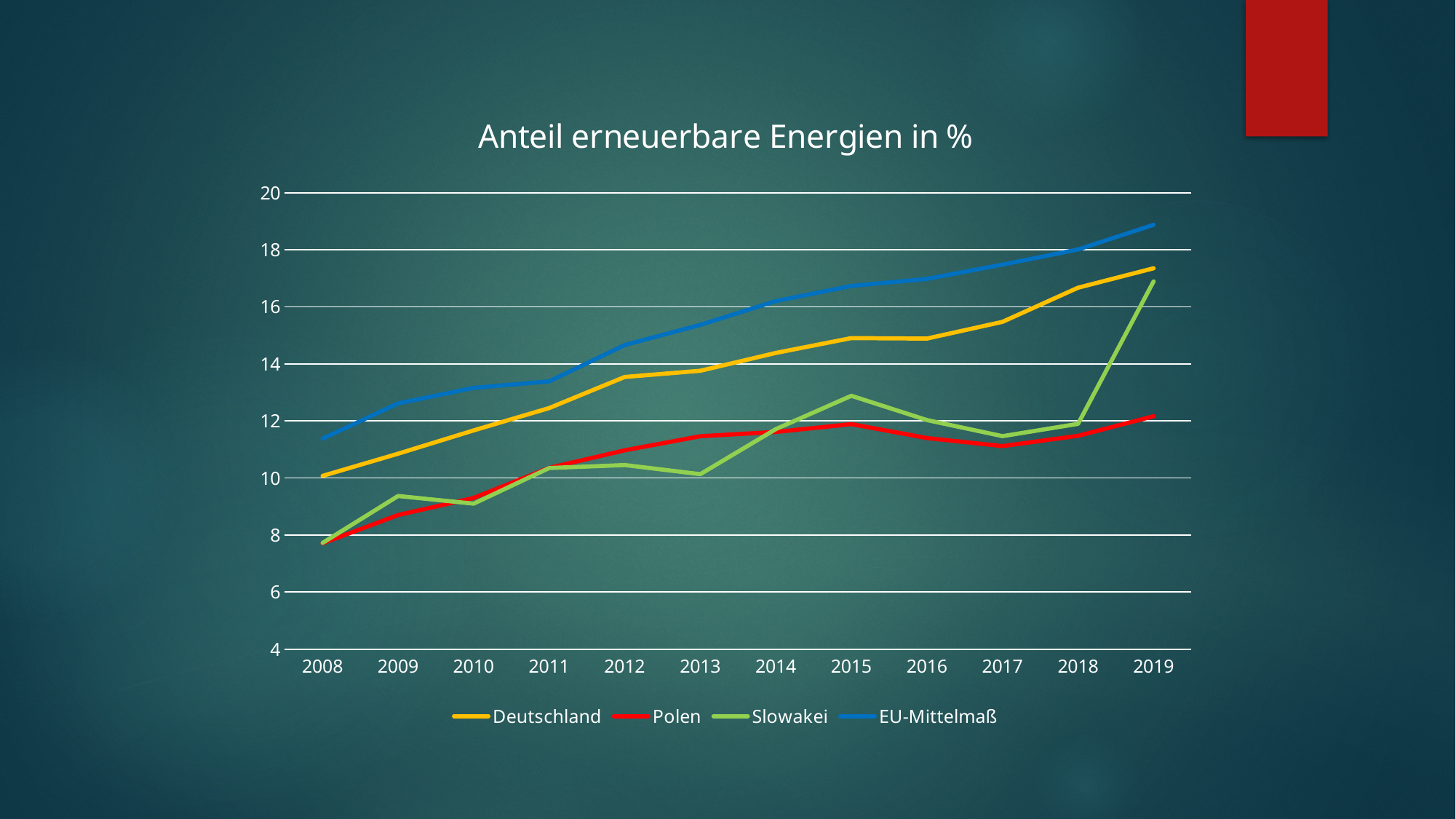
Which series has the lowest value in 2019? Polen What kind of chart is shown on the slide? line chart Is the value for EU-Mittelmaß in 2008 greater or less than 12? less How many years are shown on the x axis? 12 Is the value for Deutschland in 2019 greater or less than 16? greater What is the title of the chart? Anteil erneuerbare Energien in % Which colour is used for the Polen line? red Which series has the highest value in 2019? EU-Mittelmaß Is the value for Polen in 2019 greater or less than 14? less In 2015, which is larger: the value for Slowakei or the value for Polen? Slowakei Does the EU-Mittelmaß line rise or fall from 2008 to 2019? rise How many series does the legend list? 4